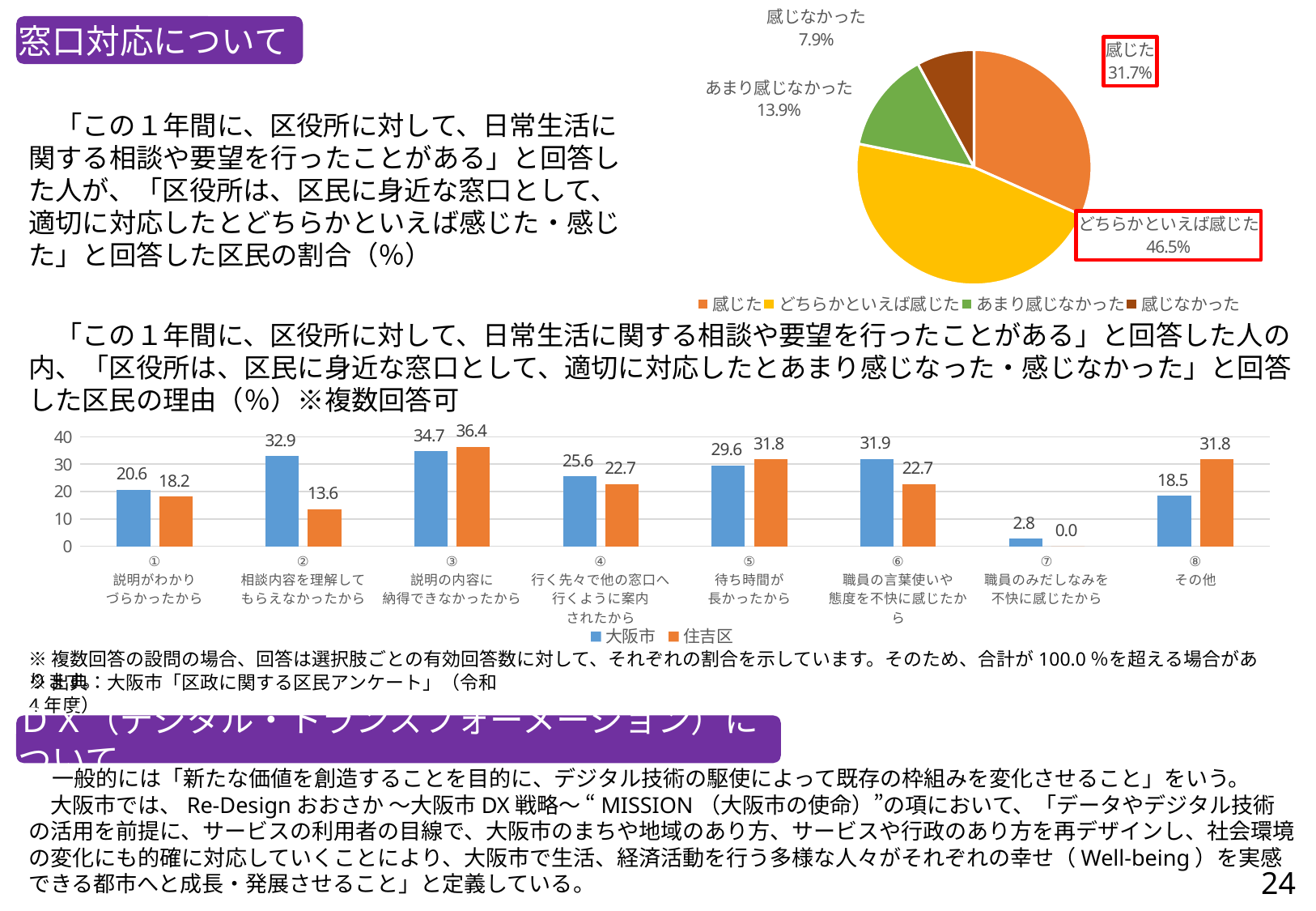
In the bar chart at the bottom, what is the value for 住吉区 in category ②? 13.6 In the bar chart at the bottom, which category has the lowest value for 大阪市? ⑦ In the pie chart at the top right, what share is labelled for 感じなかった? 7.9% In the bar chart at the bottom, which category has the highest value for 住吉区? ③ In the bar chart at the bottom, how many series does the legend list? 2 In the pie chart at the top right, which category has the smallest slice? 感じなかった In the bar chart at the bottom, what is the difference between 大阪市 and 住吉区 in category ②? 19.3 In the bar chart at the bottom, what is the value for 大阪市 in category ⑥? 31.9 In the bar chart at the bottom, which is larger in category ⑧, 大阪市 or 住吉区? 住吉区 In the pie chart at the top right, which category has the largest slice? どちらかといえば感じた In the pie chart at the top right, how many categories does the legend list? 4 In the pie chart at the top right, what share is labelled for どちらかといえば感じた? 46.5%